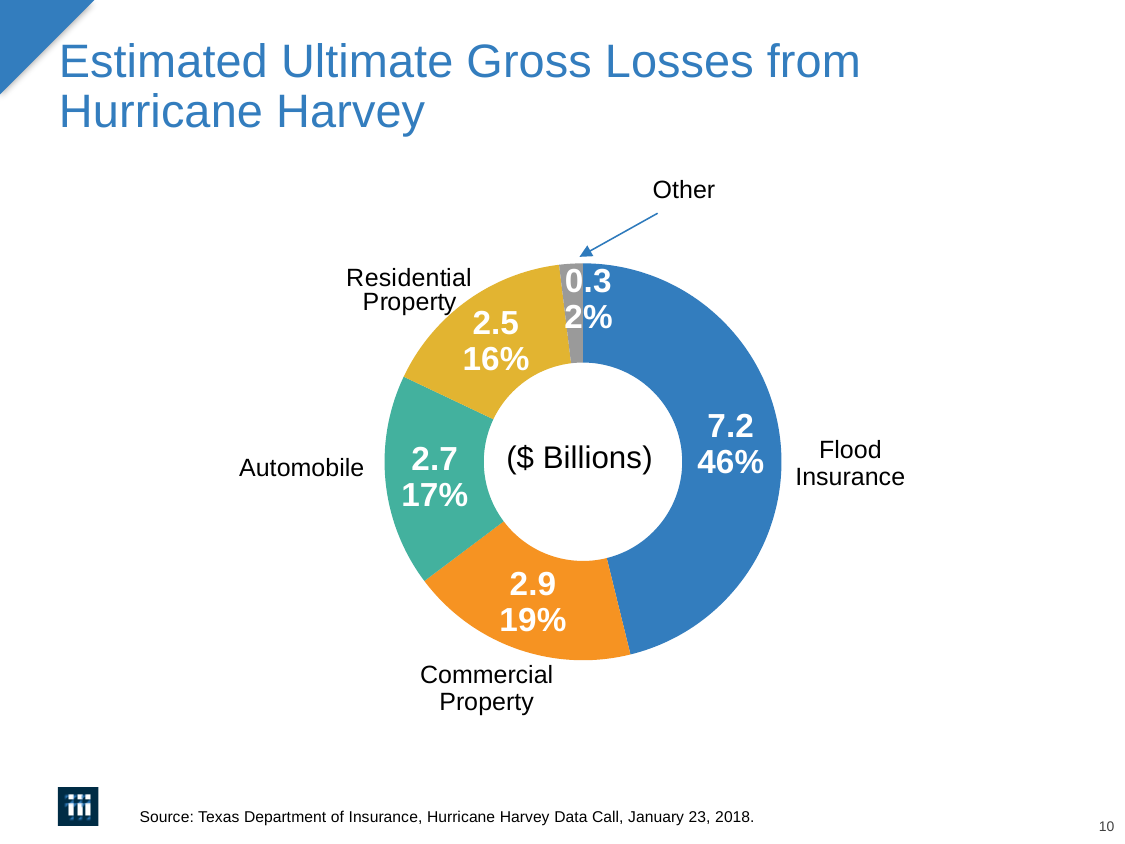
What is the estimated ultimate gross loss for Flood Insurance? 7.2 What kind of chart is shown on the slide? Pie chart (donut) Which is larger, the value for Automobile or the value for Residential Property? Automobile What is the difference between the Flood Insurance value and the Commercial Property value? 4.3 Which category has the largest estimated loss? Flood Insurance What share of the estimated losses is attributed to Commercial Property? 19% What share of the total does the Other category represent? 2% Which category has the smallest estimated loss? Other What is the value shown for Automobile? 2.7 What percentage of the total is Residential Property? 16% How many categories are shown in the chart? 5 What unit are the values in the chart expressed in? $ Billions